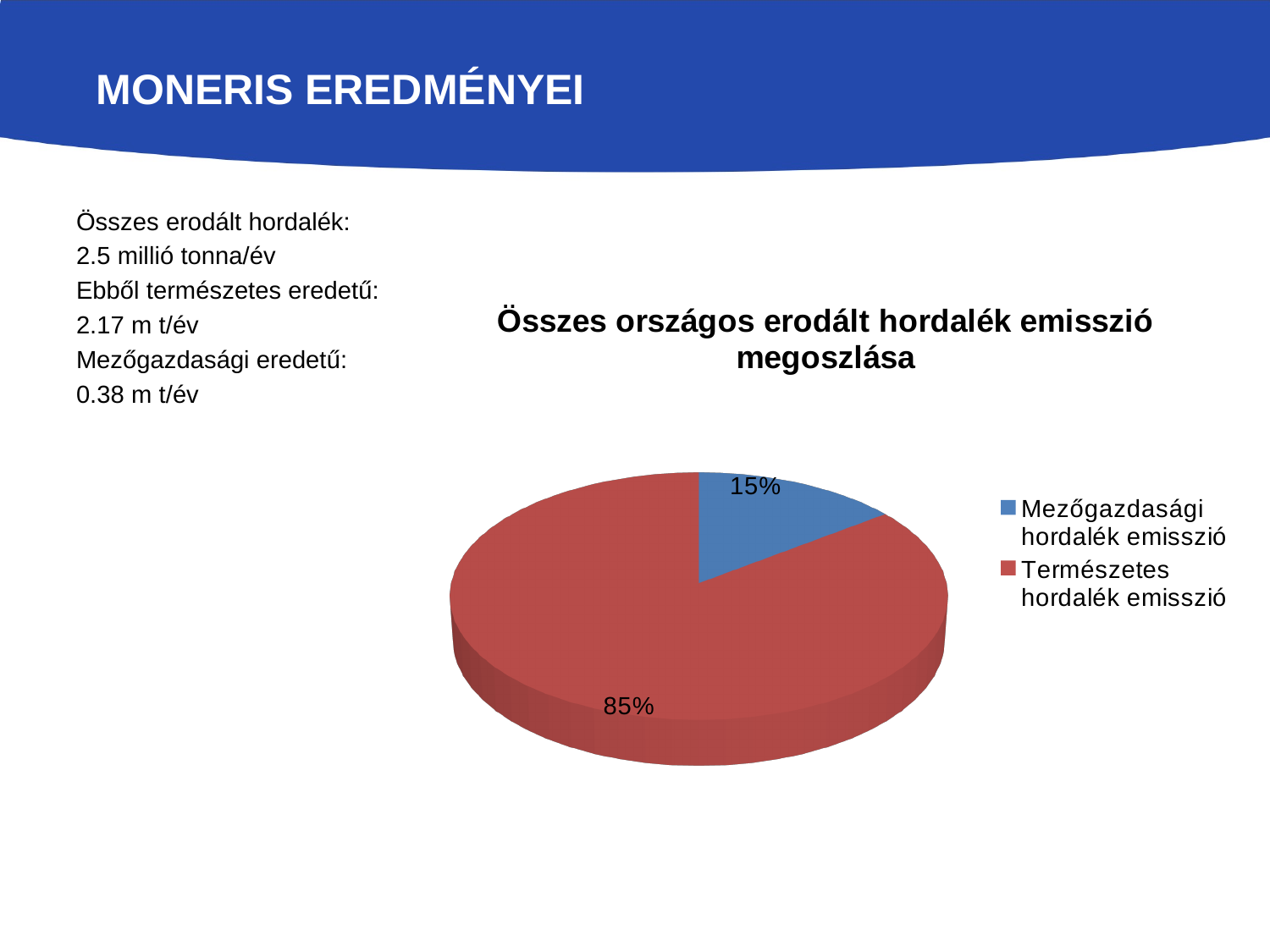
What share of the pie does Mezőgazdasági hordalék emisszió represent? 15% Which slice is the largest in the pie chart? Természetes hordalék emisszió What kind of chart is shown on the slide? Pie chart How many slices does the pie chart have? 2 Which slice is the smallest in the pie chart? Mezőgazdasági hordalék emisszió Which is larger: the Mezőgazdasági hordalék emisszió slice or the Természetes hordalék emisszió slice? Természetes hordalék emisszió What is the title of the chart? Összes országos erodált hordalék emisszió megoszlása What is the difference in percentage points between the Természetes and Mezőgazdasági slices? 70 percentage points What share of the pie does Természetes hordalék emisszió represent? 85% How many entries does the legend list? 2 What colour is the Természetes hordalék emisszió slice? Red